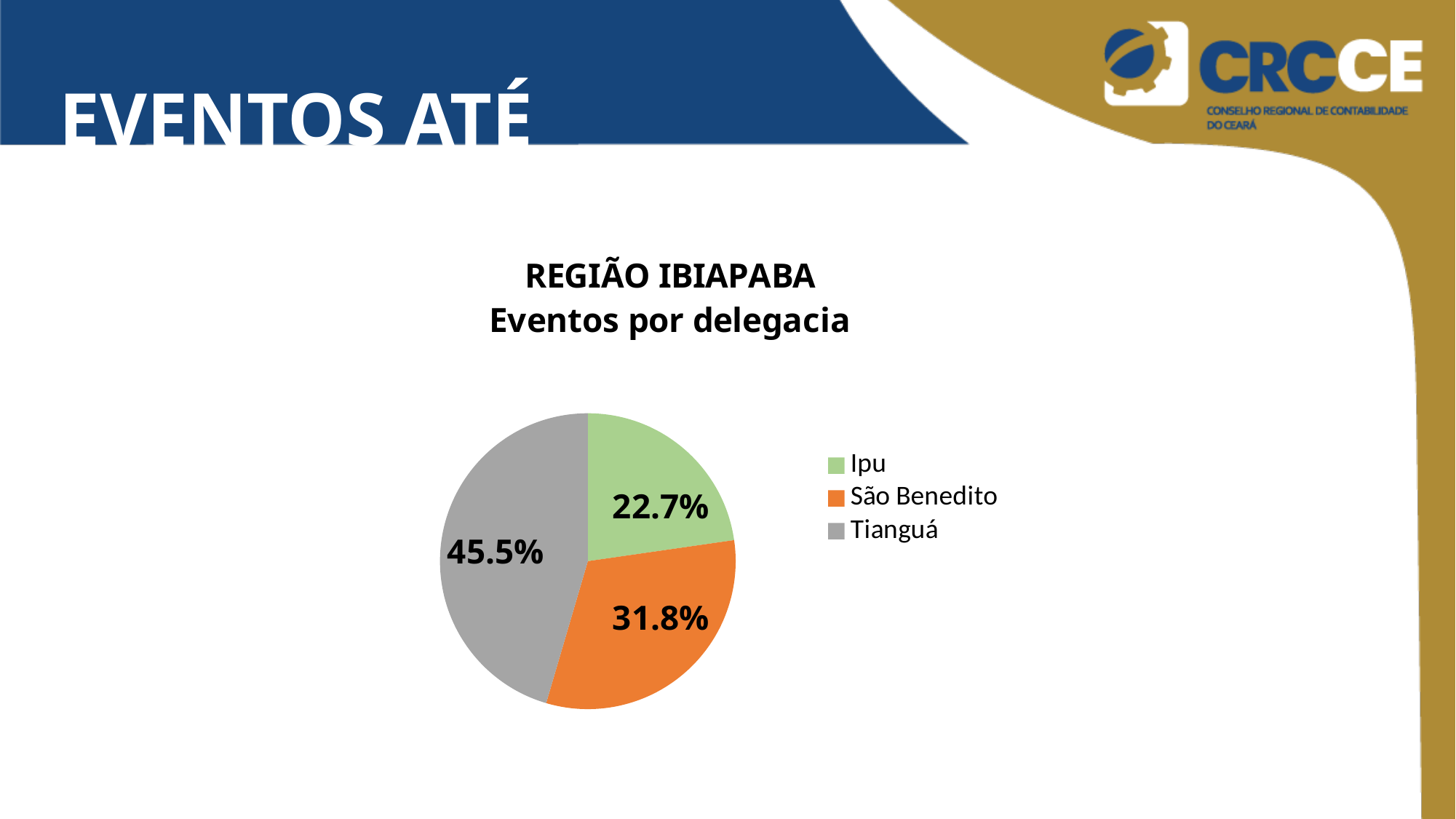
What percentage of the pie chart does Ipu represent? 22.7% How many slices does the pie chart have? 3 What is the difference in percentage points between São Benedito and Ipu? 9.1 What percentage of the pie chart does Tianguá represent? 45.5% Which colour represents São Benedito in the pie chart? Orange What is the title of the chart? REGIÃO IBIAPABA Eventos por delegacia What type of chart is shown on the slide? Pie chart Which delegacia has the smallest share of events? Ipu Which delegacia has the largest share of events? Tianguá What is the difference in percentage points between Tianguá and Ipu? 22.8 Which has a larger share, São Benedito or Ipu? São Benedito What percentage of the pie chart does São Benedito represent? 31.8%